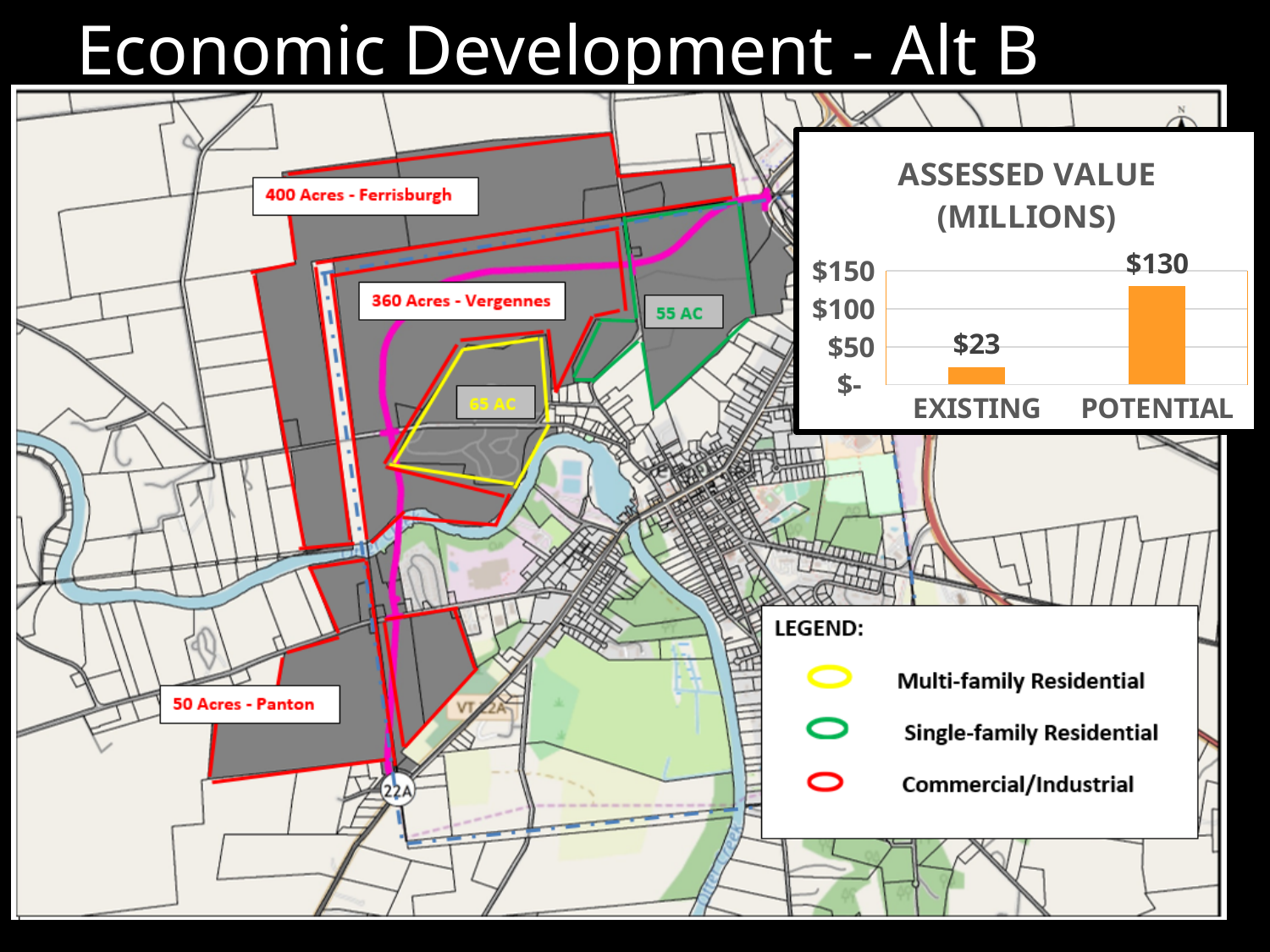
How many categories are shown in the chart? 2 Which category has the lower assessed value? EXISTING What kind of chart is shown on the slide? bar chart Do the values rise or fall from EXISTING to POTENTIAL? rise Is the assessed value for POTENTIAL greater or less than $100? greater What is the highest value shown on the chart's vertical axis? $150 What is the assessed value for POTENTIAL in the chart? $130 What is the assessed value for EXISTING in the chart? $23 Which category has the higher assessed value? POTENTIAL What is the title of the chart? ASSESSED VALUE (MILLIONS) Is the assessed value for EXISTING greater or less than $50? less What is the difference between the POTENTIAL and EXISTING assessed values? $107